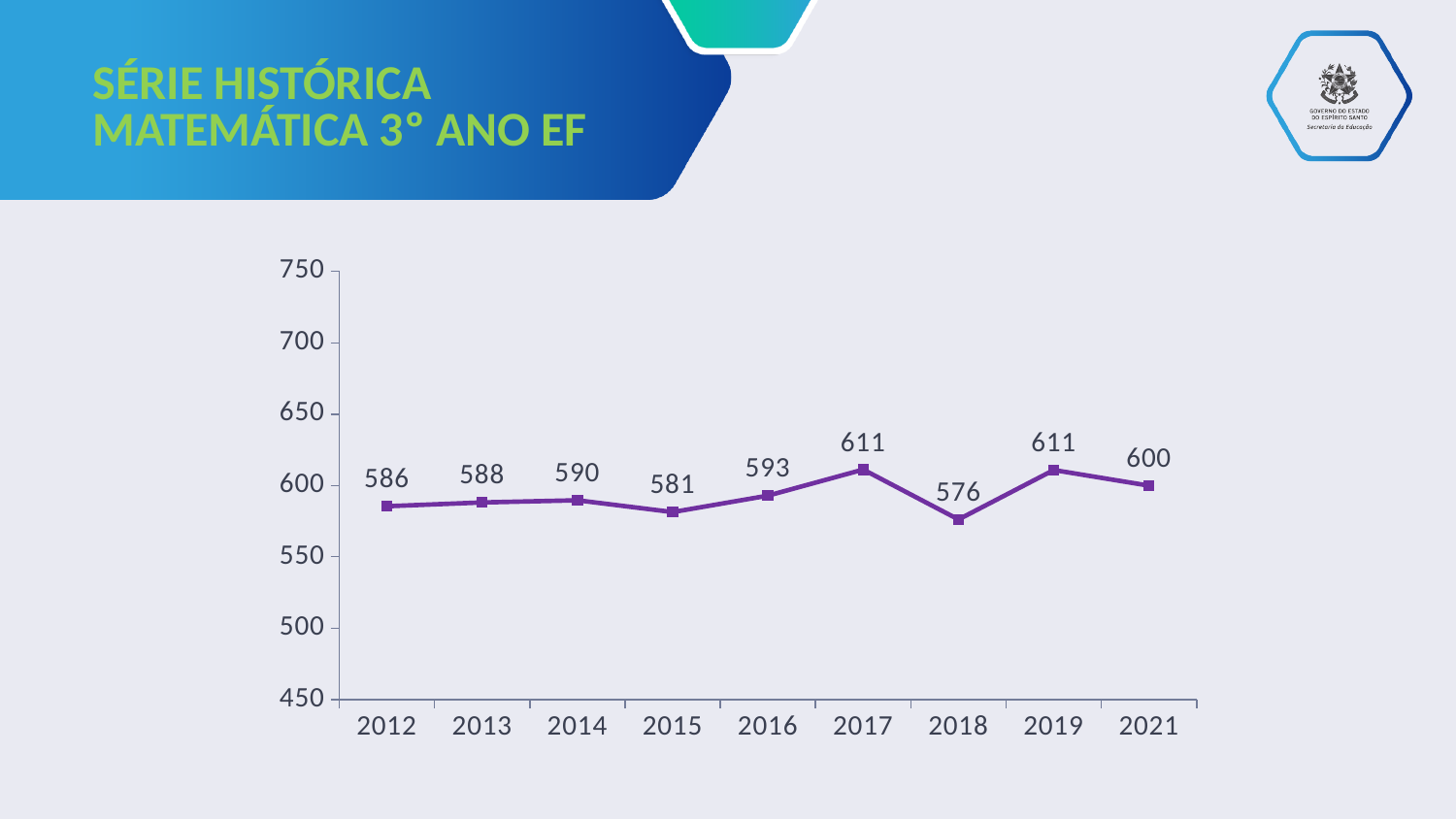
What kind of chart is shown on the slide? line chart How many years are plotted on the chart? 9 Which year has the lowest value? 2018 Does the value rise or fall from 2017 to 2018? fall What is the difference between the values for 2017 and 2018? 35 What is the value for 2018? 576 Is the value for 2018 greater or less than 600? less What is the value for 2012? 586 What is the highest value shown on the chart? 611 Which is larger, the value for 2015 or the value for 2016? 2016 What is the value for 2021? 600 What is the difference between the values for 2021 and 2012? 14